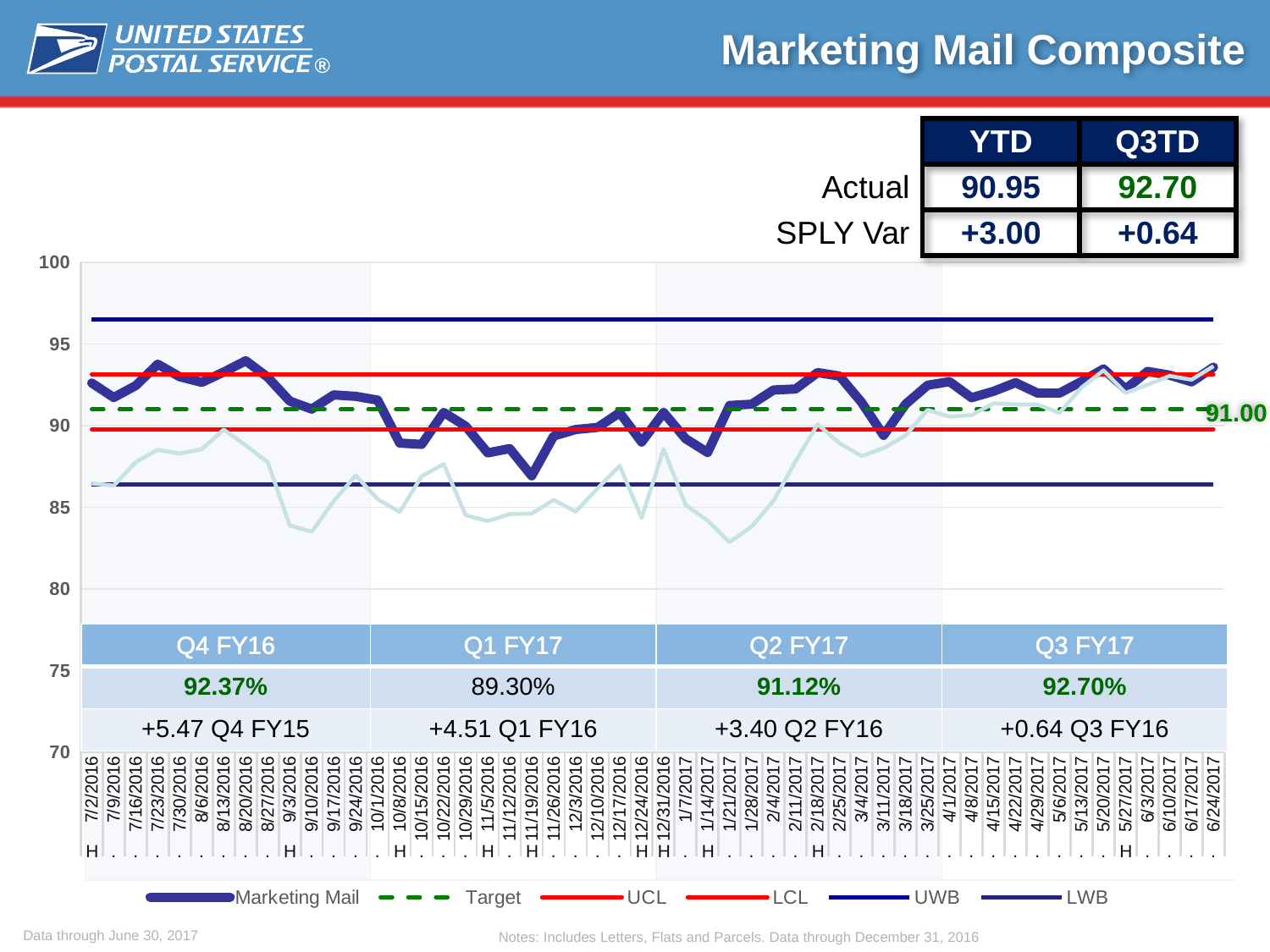
How many series does the chart legend list? 6 What is the Marketing Mail value shown for Q3 FY17 in the quarter table below the chart? 92.70% Is the Marketing Mail value for 11/19/2016 greater or less than 90? less Which quarter in the table below the chart has the highest value? Q3 FY17 Which quarter in the table below the chart has the lowest value? Q1 FY17 Which is larger, the Q4 FY16 value or the Q2 FY17 value? Q4 FY16 What kind of chart is shown on the slide? line chart What value is labelled for the Target line on the chart? 91.00 What is the lowest value shown on the chart's vertical axis? 70 What is the Marketing Mail value shown for Q1 FY17 in the quarter table below the chart? 89.30% Is the Marketing Mail value for 8/20/2016 greater or less than 90? greater What is the difference between the Q3 FY17 value (92.70%) and the Q1 FY17 value (89.30%)? 3.40